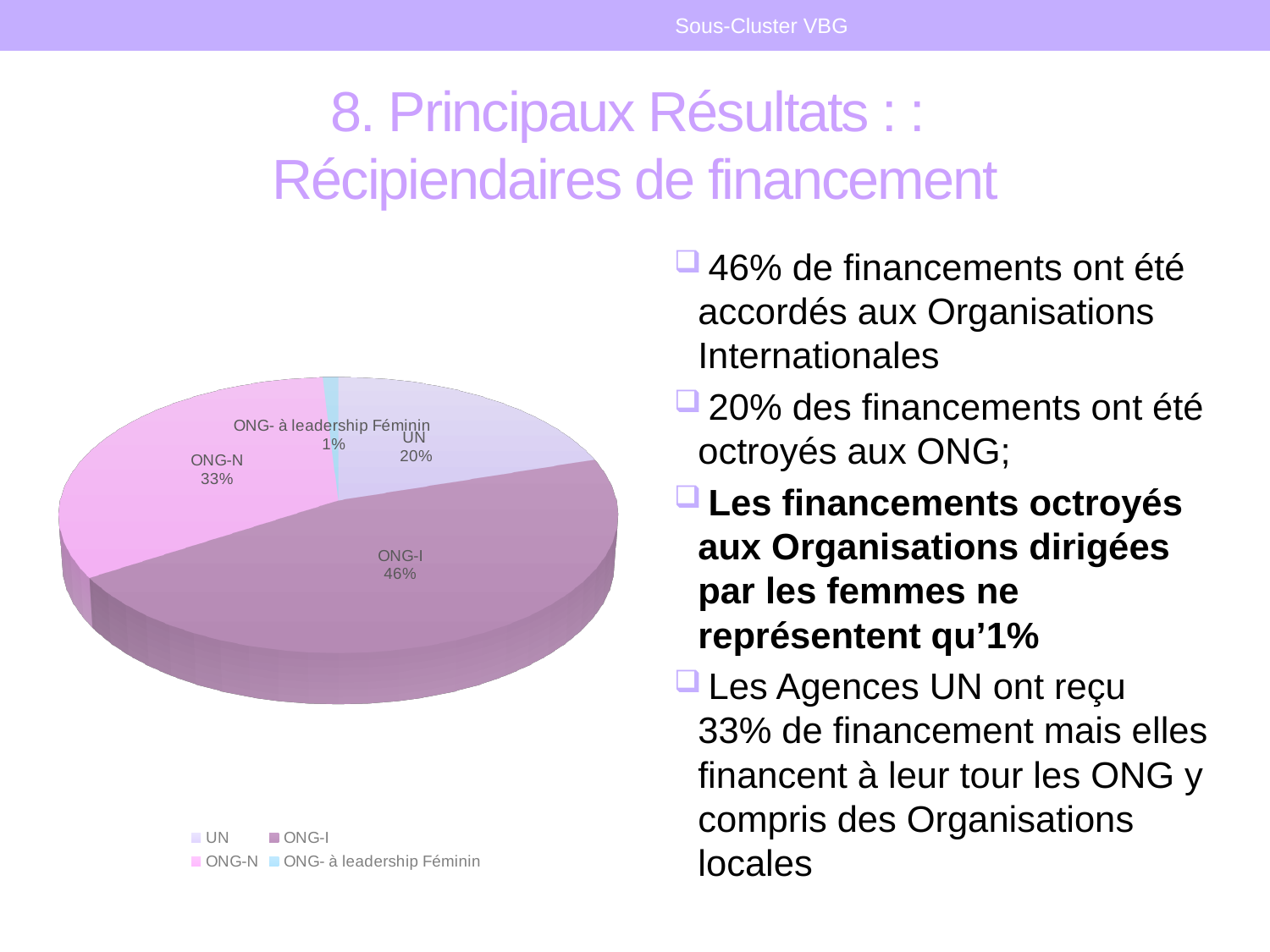
What share of the pie does UN represent? 20% Which is larger, the UN slice or the ONG-N slice? ONG-N What share of the pie does ONG-N represent? 33% What is the difference in percentage points between the ONG-N slice and the UN slice? 13 What is the difference in percentage points between the ONG-I slice and the ONG-N slice? 13 Which category has the smallest slice of the pie? ONG- à leadership Féminin Which category has the largest slice of the pie? ONG-I What share of the pie does ONG- à leadership Féminin represent? 1% What kind of chart is shown on the slide? pie chart How many entries does the legend list? 4 How many categories are shown in the pie chart? 4